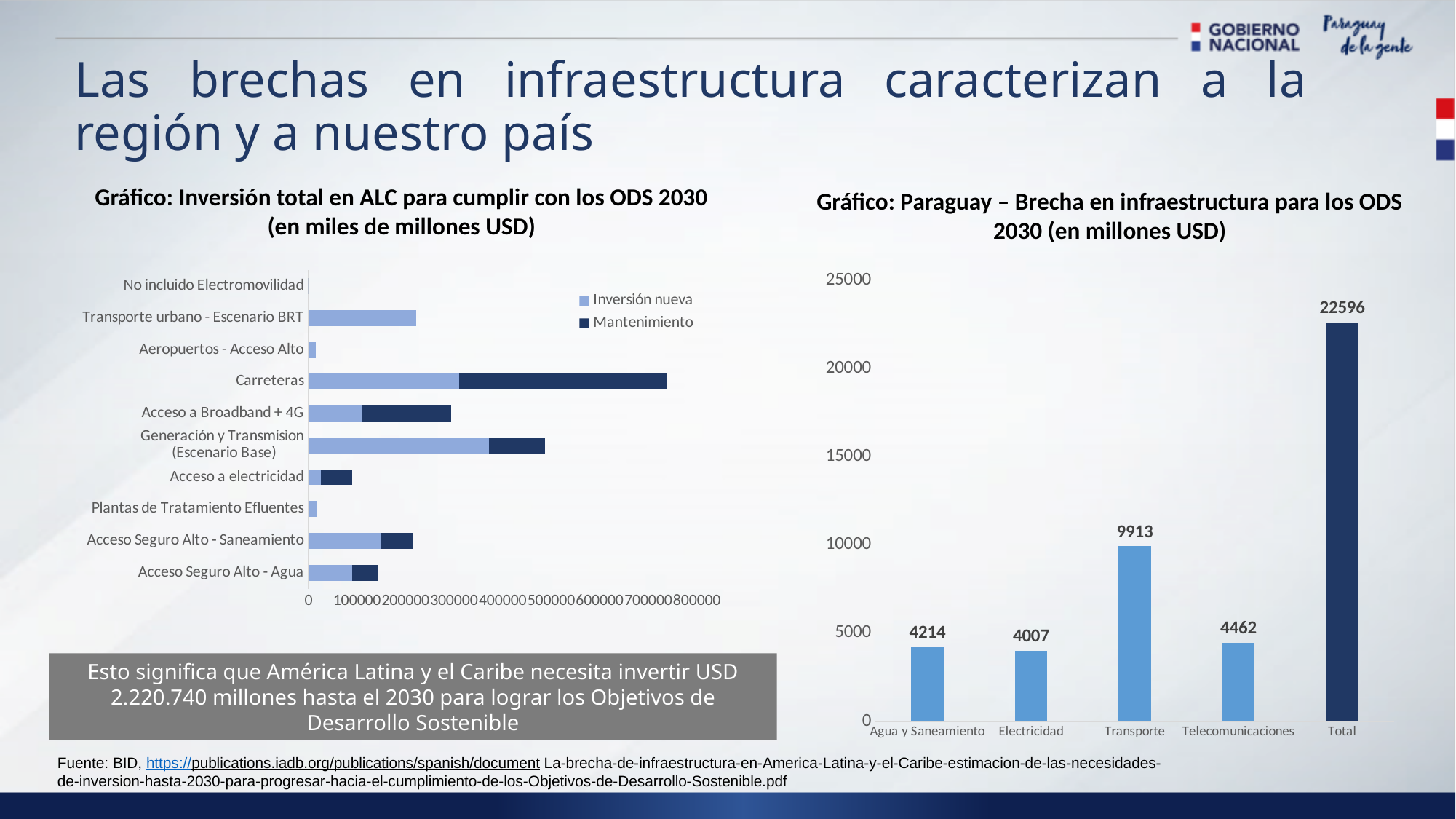
In the chart 'Paraguay – Brecha en infraestructura para los ODS 2030', which sector has the lowest value? Electricidad What type of chart is 'Inversión total en ALC para cumplir con los ODS 2030'? Bar chart How many series does the legend list in the chart 'Inversión total en ALC para cumplir con los ODS 2030'? 2 In the chart 'Paraguay – Brecha en infraestructura para los ODS 2030', what is the value of the Total bar? 22596 In the chart 'Paraguay – Brecha en infraestructura para los ODS 2030', what is the value for Electricidad? 4007 In the chart 'Paraguay – Brecha en infraestructura para los ODS 2030', which is larger, Agua y Saneamiento or Telecomunicaciones? Telecomunicaciones In the chart 'Paraguay – Brecha en infraestructura para los ODS 2030', which sector (excluding Total) has the highest value? Transporte In the chart 'Paraguay – Brecha en infraestructura para los ODS 2030', what is the difference between Telecomunicaciones and Agua y Saneamiento? 248 In the chart 'Paraguay – Brecha en infraestructura para los ODS 2030', what is the value for Transporte? 9913 How many bars are shown in the chart 'Paraguay – Brecha en infraestructura para los ODS 2030'? 5 In the chart 'Inversión total en ALC para cumplir con los ODS 2030', is the total value for Carreteras greater or less than 600000? greater In the chart 'Inversión total en ALC para cumplir con los ODS 2030', which category has the longest total bar? Carreteras